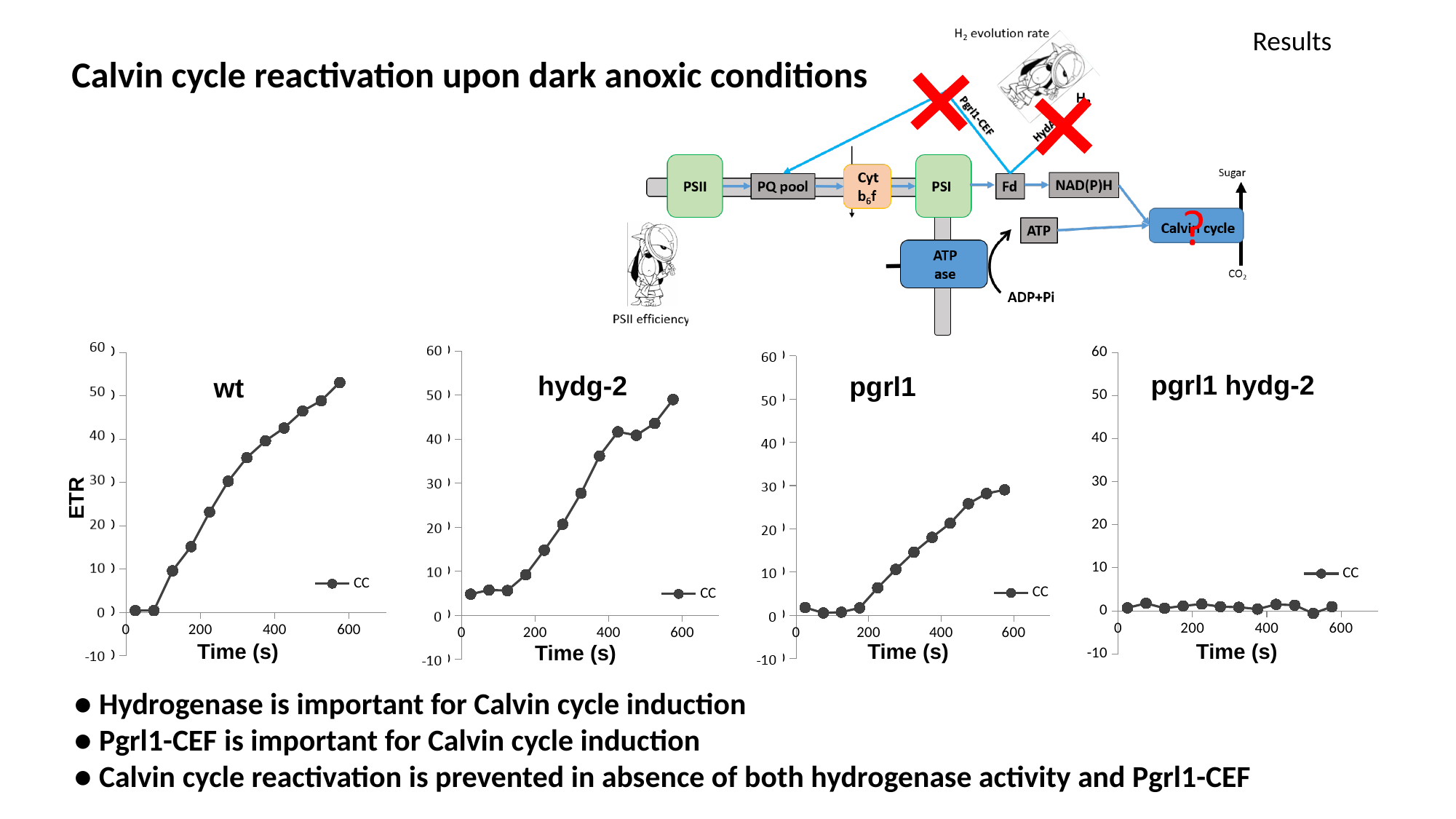
In the hydg-2 chart, is the ETR value at the last time point (around 575 s) greater or less than 40? greater In the wt chart, is the ETR value at the last time point (around 575 s) greater or less than 50? greater In the pgrl1 chart, is the ETR value at the last time point (around 575 s) greater or less than 20? greater What kind of chart is the wt chart? line chart Which chart reaches a higher ETR at the final time point, hydg-2 or pgrl1 hydg-2? hydg-2 Which chart reaches a higher ETR at the final time point, wt or pgrl1? wt What is the x-axis label of the pgrl1 chart? Time (s) In the pgrl1 hydg-2 chart, does ETR rise, fall, or stay roughly flat as time increases? stay roughly flat How many series does the legend of the hydg-2 chart list? 1 In the wt chart, does ETR rise or fall as time increases? rise What is the y-axis label of the wt chart? ETR